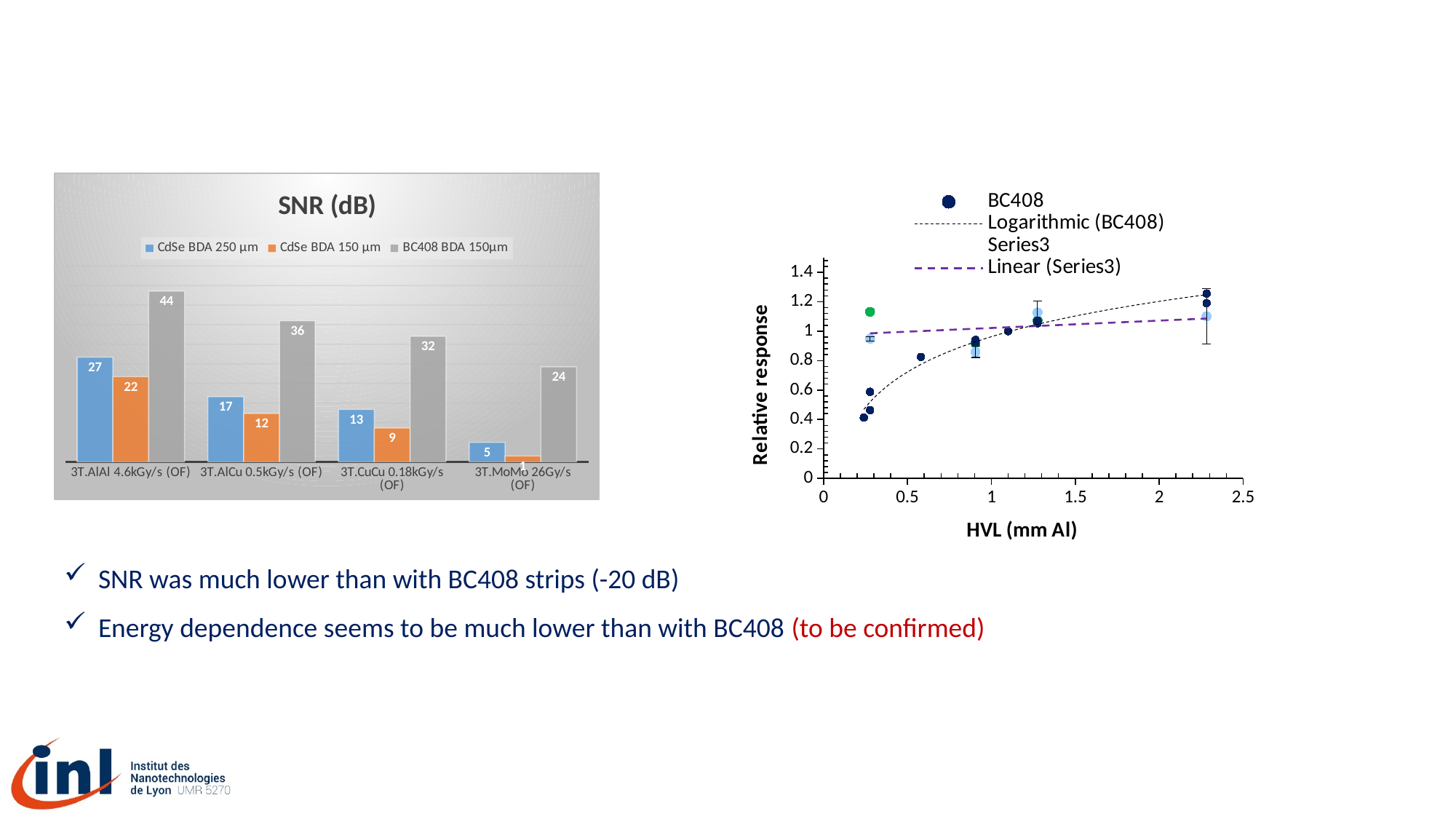
In the Relative response vs HVL chart on the right, do the BC408 values rise or fall as HVL increases? Rise How many categories are shown on the x axis of the SNR (dB) chart? 4 In the SNR (dB) chart, which category has the highest SNR for BC408 BDA 150µm? 3T.AlAl 4.6kGy/s (OF) In the SNR (dB) chart, what is the SNR for CdSe BDA 150 µm at 3T.AlCu 0.5kGy/s (OF)? 12 What kind of chart is the SNR (dB) chart on the left? Bar chart In the SNR (dB) chart, what is the difference between the BC408 BDA 150µm and CdSe BDA 250 µm values at 3T.AlCu 0.5kGy/s (OF)? 19 How many entries does the legend of the Relative response vs HVL chart on the right list? 4 How many series does the legend of the SNR (dB) chart list? 3 In the SNR (dB) chart, what is the SNR for CdSe BDA 250 µm at 3T.CuCu 0.18kGy/s (OF)? 13 In the SNR (dB) chart, what is the SNR for BC408 BDA 150µm at 3T.AlAl 4.6kGy/s (OF)? 44 In the SNR (dB) chart, which is larger at 3T.CuCu 0.18kGy/s (OF): CdSe BDA 250 µm or CdSe BDA 150 µm? CdSe BDA 250 µm In the SNR (dB) chart, which category has the lowest SNR for CdSe BDA 250 µm? 3T.MoMo 26Gy/s (OF)